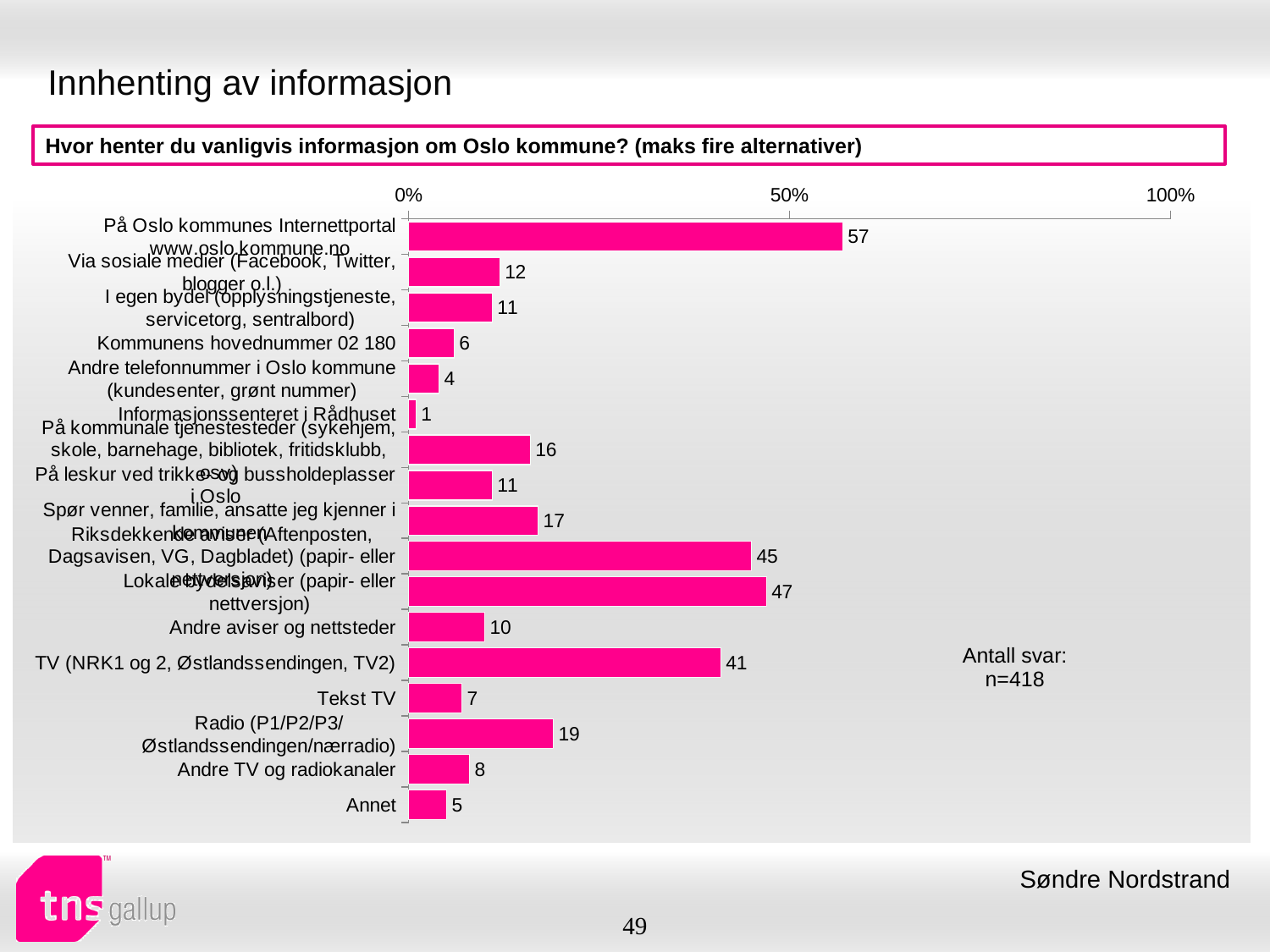
Which category has the lowest value? Informasjonssenteret i Rådhuset What kind of chart is shown on the slide? Bar chart What value is shown for "Annet"? 5 Which is larger: the value for "Radio (P1/P2/P3/Østlandssendingen/nærradio)" or the value for "Andre TV og radiokanaler"? Radio (P1/P2/P3/Østlandssendingen/nærradio) What value is shown for "TV (NRK1 og 2, Østlandssendingen, TV2)"? 41 What is the difference between the values for "Lokale bydelsaviser (papir- eller nettversjon)" and "Andre aviser og nettsteder"? 37 Which category has the highest value? På Oslo kommunes Internettportal www.oslo.kommune.no Is the value for "På Oslo kommunes Internettportal www.oslo.kommune.no" greater or less than 50%? greater What value is shown for "Tekst TV"? 7 What is the number of respondents (n) stated on the slide? n=418 How many categories are shown in the chart? 17 What value is shown for "Kommunens hovednummer 02 180"? 6